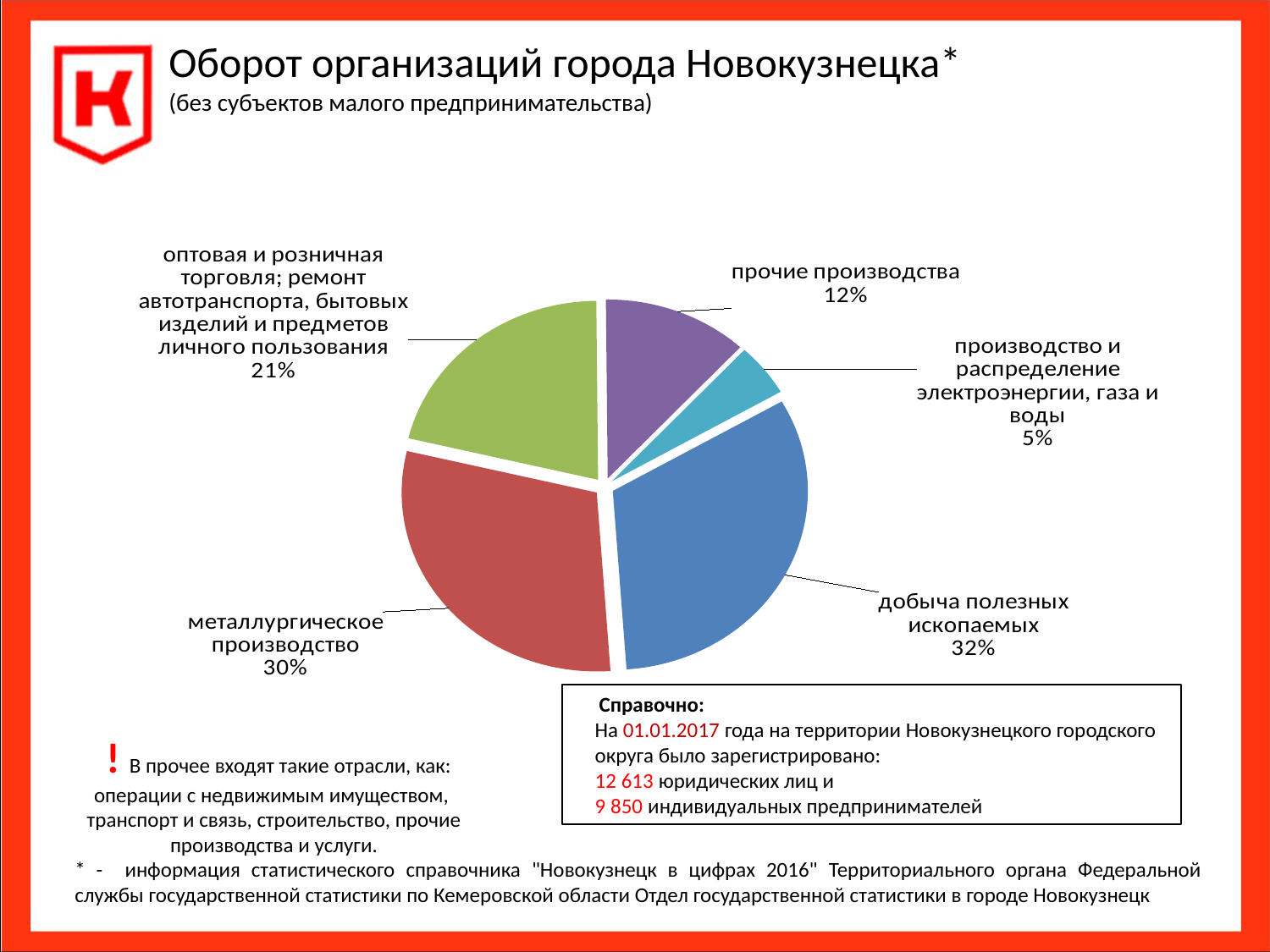
Какова доля производства и распределения электроэнергии, газа и воды? 5% На сколько процентных пунктов доля добычи полезных ископаемых больше доли металлургического производства? 2 Какова доля металлургического производства? 30% Какой тип диаграммы показан на слайде? круговая диаграмма Что больше: доля оптовой и розничной торговли или доля прочих производств? оптовая и розничная торговля Какая отрасль имеет наибольшую долю в обороте? добыча полезных ископаемых Какова доля добычи полезных ископаемых в обороте организаций? 32% Каким цветом показан сектор металлургического производства? красным Какая отрасль имеет наименьшую долю в обороте? производство и распределение электроэнергии, газа и воды Сколько секторов (отраслей) показано на круговой диаграмме? 5 Какова доля прочих производств? 12% Какова доля оптовой и розничной торговли; ремонта автотранспорта, бытовых изделий и предметов личного пользования? 21%